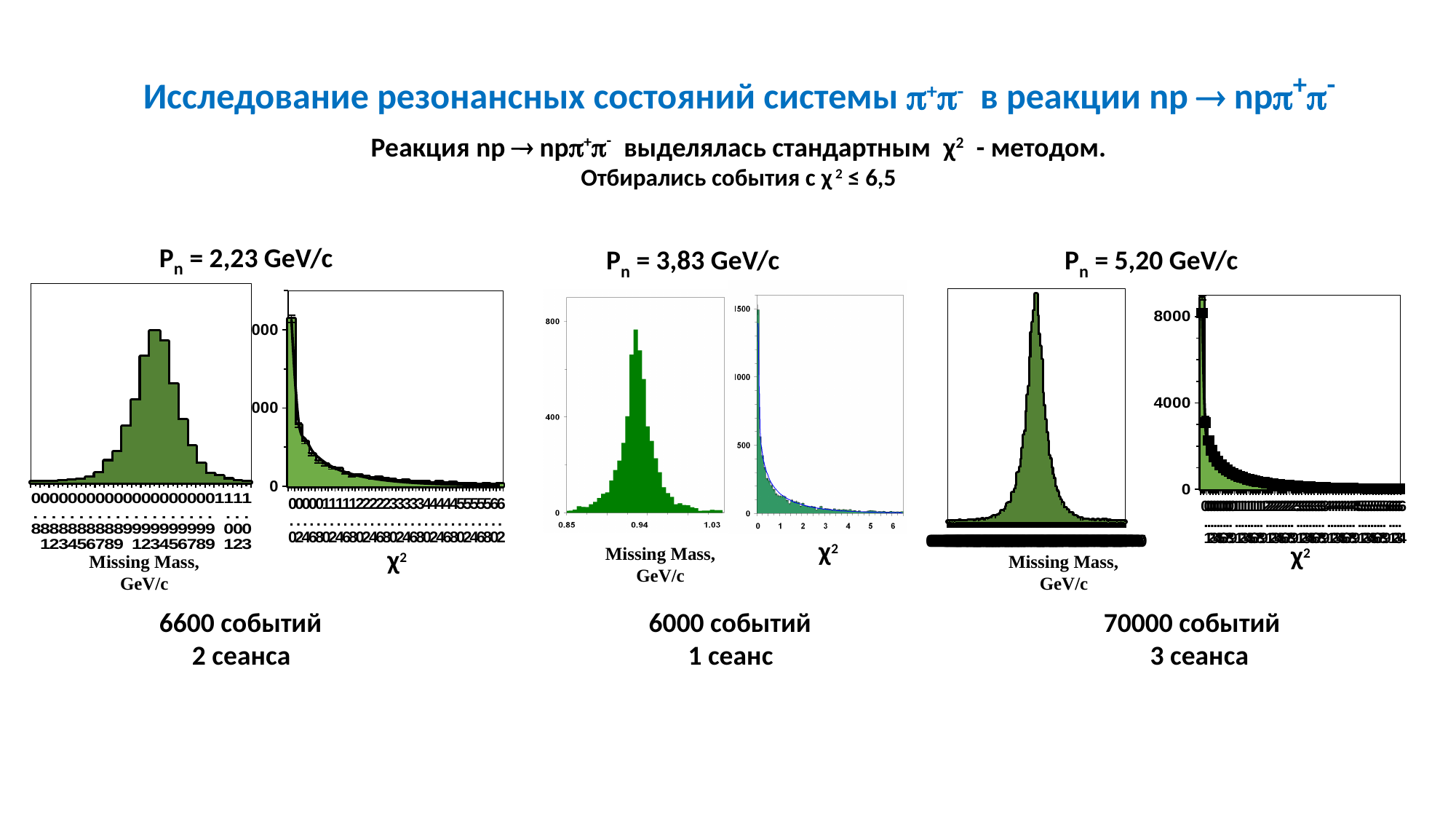
How many charts are shown on the slide in total? 6 How many charts are shown for P_n = 5,20 GeV/c? 2 In the χ² chart for P_n = 3,83 GeV/c, which is larger: the value near χ² = 0 or the value near χ² = 6? near χ² = 0 In the χ² chart for P_n = 3,83 GeV/c, do the values rise or fall as χ² increases along the x axis? fall What kind of chart is the Missing Mass plot for P_n = 3,83 GeV/c? bar chart (histogram) In the χ² chart for P_n = 5,20 GeV/c, is the value of the first bin greater or less than 4000? greater In the Missing Mass chart for P_n = 3,83 GeV/c, at which x-axis tick value does the peak of the histogram lie? 0.94 In the χ² chart for P_n = 5,20 GeV/c, do the values rise or fall along the x axis? fall In the Missing Mass chart for P_n = 3,83 GeV/c, is the value of the tallest bar greater or less than 400? greater What is the x-axis label of the left chart in each pair of charts? Missing Mass, GeV/c What is the x-axis label of the right chart in each pair of charts? χ² In the χ² chart for P_n = 3,83 GeV/c, is the value of the first bin (near χ² = 0) greater or less than 1000? greater